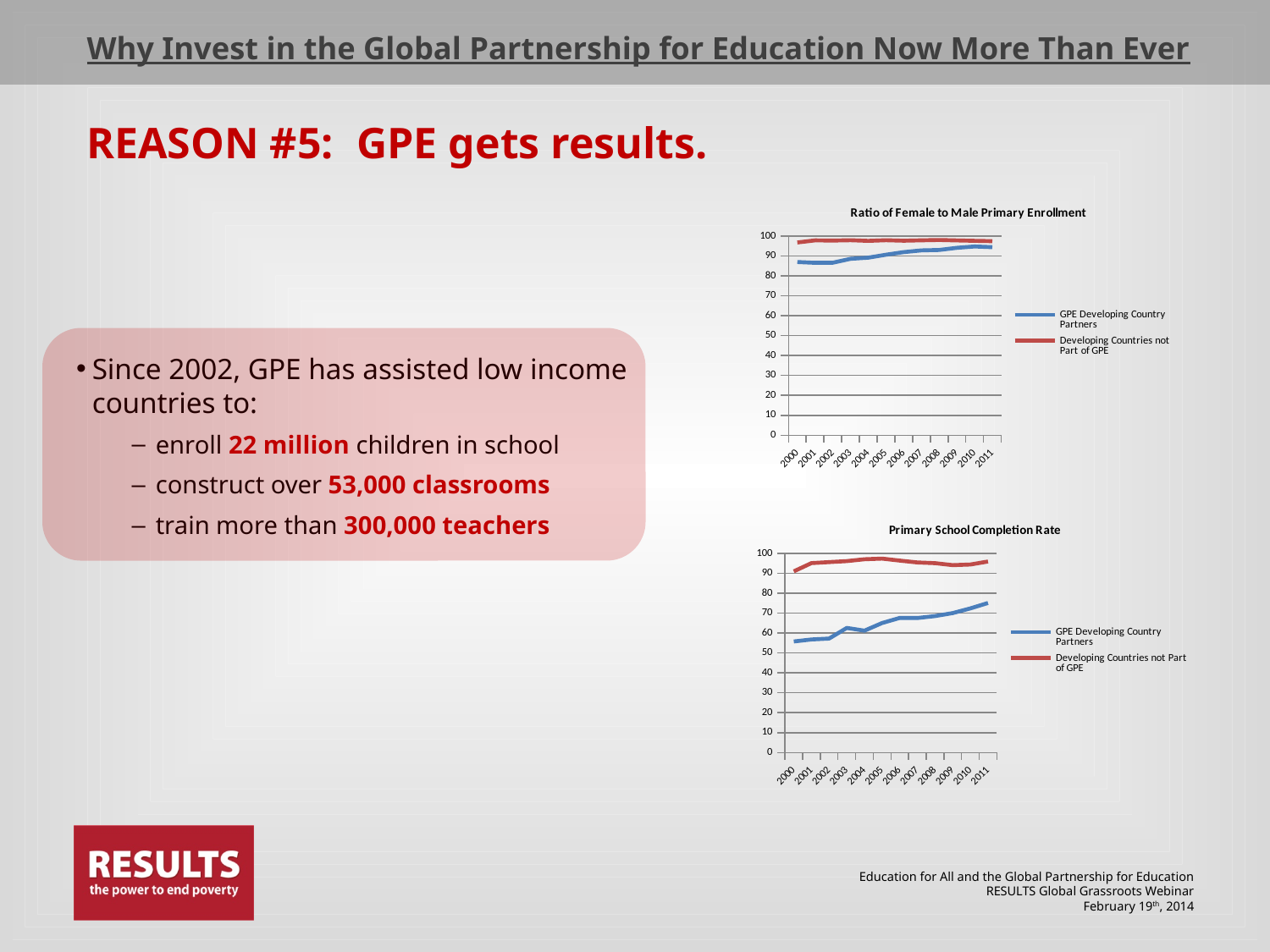
In the 'Ratio of Female to Male Primary Enrollment' chart, does the GPE Developing Country Partners line rise or fall from 2000 to 2011? Rise In the 'Primary School Completion Rate' chart, which series has the higher value in 2000? Developing Countries not Part of GPE In the 'Ratio of Female to Male Primary Enrollment' chart, is the value for GPE Developing Country Partners in 2000 greater or less than 90? less What kind of chart is the 'Primary School Completion Rate' chart? Line chart How many series does the legend of the 'Primary School Completion Rate' chart list? 2 In the 'Primary School Completion Rate' chart, does the GPE Developing Country Partners line rise or fall from 2000 to 2011? Rise In the 'Primary School Completion Rate' chart, is the value for GPE Developing Country Partners in 2000 greater or less than 60? less What is the title of the lower chart on the slide? Primary School Completion Rate How many years are shown on the x axis of the 'Ratio of Female to Male Primary Enrollment' chart? 12 In the 'Ratio of Female to Male Primary Enrollment' chart, which series is shown in blue? GPE Developing Country Partners In the 'Primary School Completion Rate' chart, is the value for GPE Developing Country Partners in 2011 greater or less than 70? greater What kind of chart is the 'Ratio of Female to Male Primary Enrollment' chart? Line chart